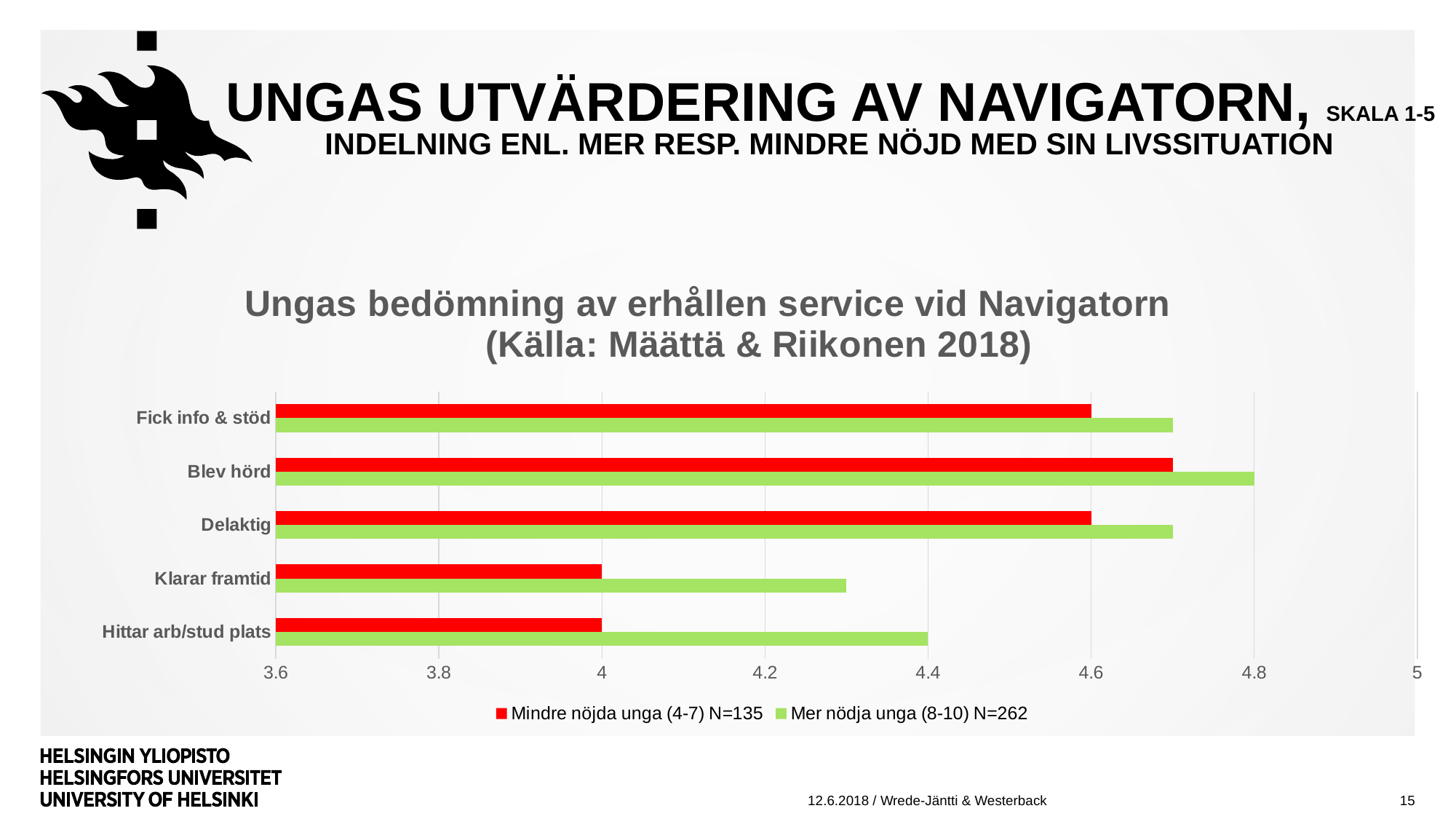
What is the value for 'Hittar arb/stud plats' for the series 'Mer nödja unga (8-10) N=262'? 4.4 How many series does the legend list? 2 How many categories are shown on the chart? 5 Which is larger for 'Fick info & stöd': the value for 'Mindre nöjda unga (4-7) N=135' or for 'Mer nödja unga (8-10) N=262'? Mer nödja unga (8-10) N=262 What is the value for 'Fick info & stöd' for the series 'Mindre nöjda unga (4-7) N=135'? 4.6 What is the value for 'Klarar framtid' for the series 'Mindre nöjda unga (4-7) N=135'? 4 Which category has the highest value for the series 'Mer nödja unga (8-10) N=262'? Blev hörd Is the value for 'Klarar framtid' in the series 'Mer nödja unga (8-10) N=262' greater or less than 4.2? greater What is the title of the chart? Ungas bedömning av erhållen service vid Navigatorn (Källa: Määttä & Riikonen 2018) What kind of chart is shown on the slide? bar chart What is the difference between the values for 'Fick info & stöd' and 'Klarar framtid' in the series 'Mindre nöjda unga (4-7) N=135'? 0.6 What is the value for 'Blev hörd' for the series 'Mer nödja unga (8-10) N=262'? 4.8